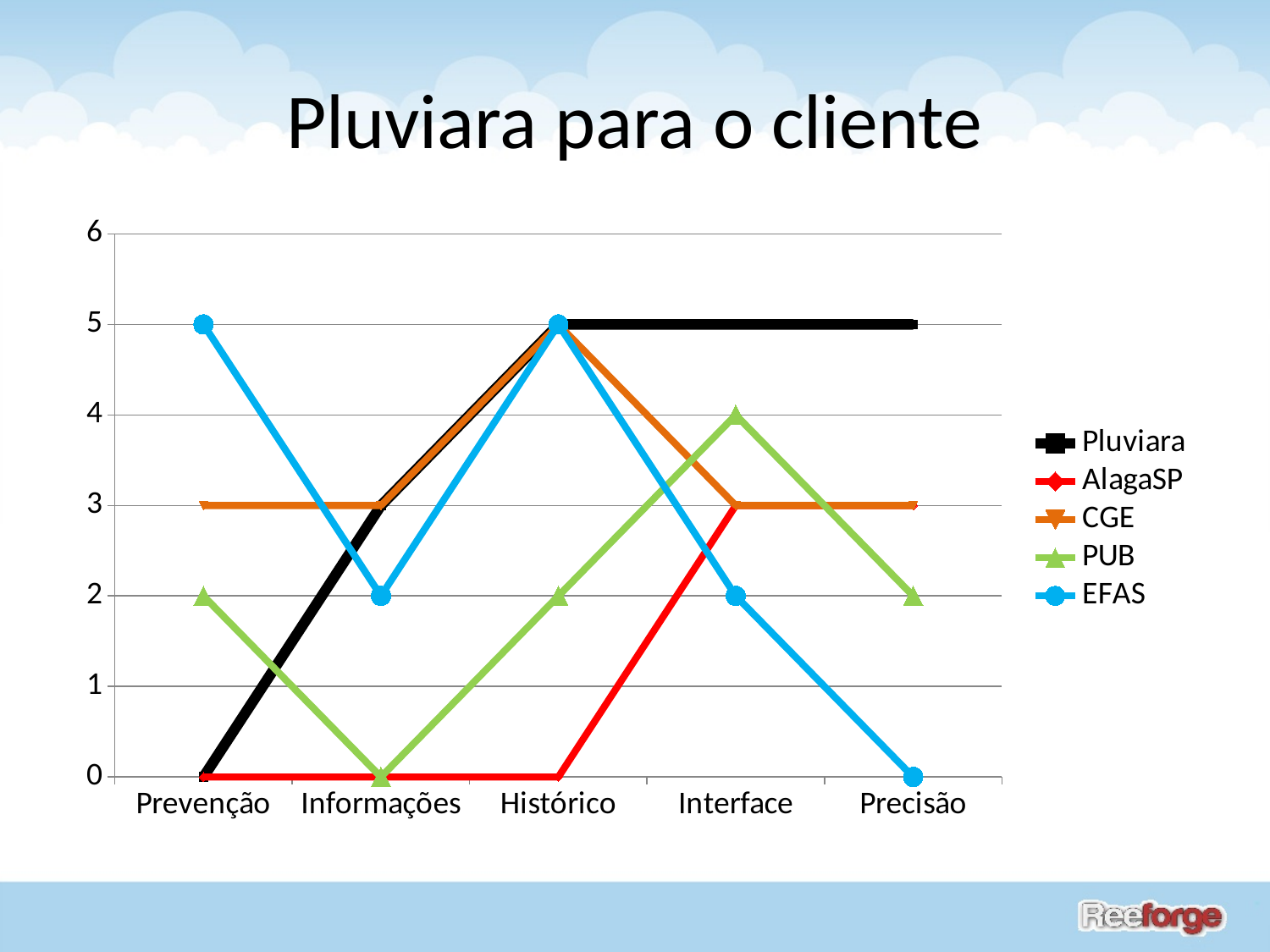
What is the value for Pluviara at Histórico? 5 How many categories are shown on the x axis? 5 What is the value for PUB at Interface? 4 Does the Pluviara series rise or fall from Prevenção to Histórico? rise Which is larger at Informações, the value for CGE or the value for EFAS? CGE Which series has the lowest value at Precisão? EFAS Which series has the highest value at Prevenção? EFAS What is the value for AlagaSP at Interface? 3 What is the difference between the Pluviara value and the AlagaSP value at Precisão? 2 What kind of chart is shown on the slide? line chart What is the value for EFAS at Precisão? 0 How many series does the legend list? 5